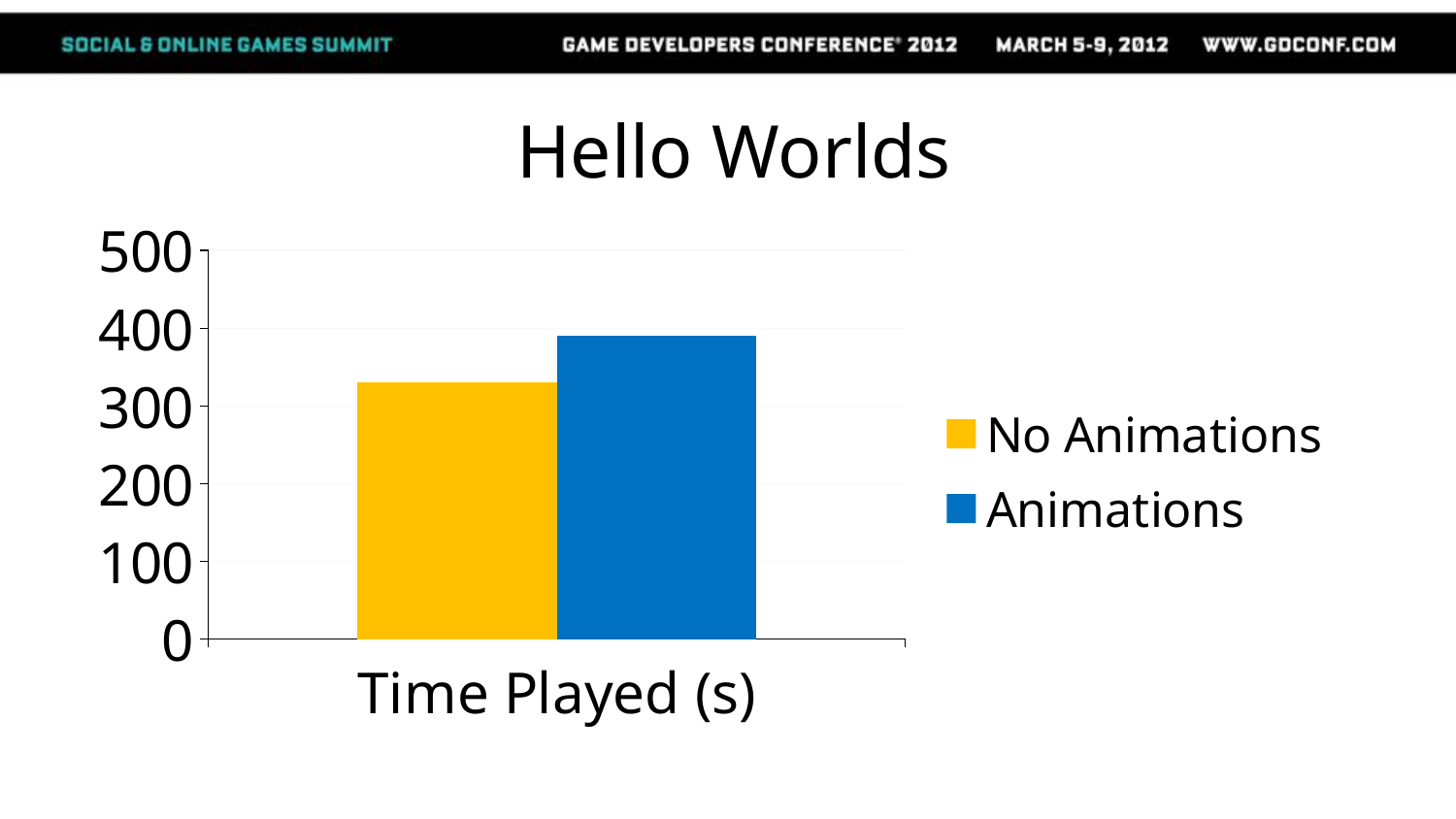
Which series has the higher value for Time Played (s), No Animations or Animations? Animations What is the label of the category on the x axis? Time Played (s) Which series has the lowest bar? No Animations How many series does the legend list? 2 What kind of chart is shown on the slide? bar chart Is the value for Animations greater or less than 500? less Is the value for No Animations greater or less than 400? less Which series has the highest bar? Animations What is the title of the chart? Hello Worlds Is the value for No Animations greater or less than 300? greater How many categories are shown on the x axis? 1